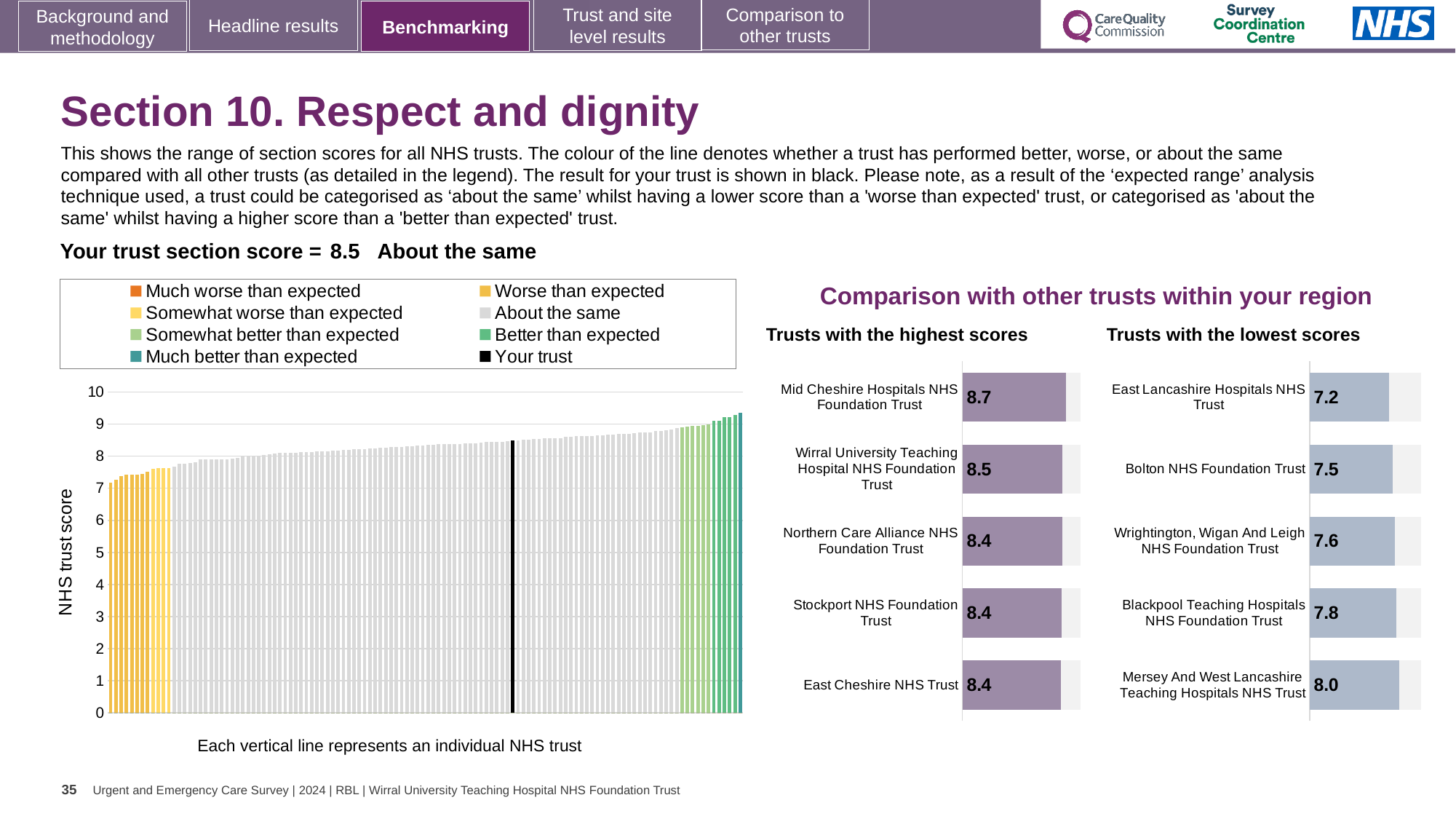
In the 'Trusts with the lowest scores' chart, which has the higher score: Bolton NHS Foundation Trust or Blackpool Teaching Hospitals NHS Foundation Trust? Blackpool Teaching Hospitals NHS Foundation Trust In the 'Trusts with the lowest scores' chart, which trust has the lowest score? East Lancashire Hospitals NHS Trust In the 'Trusts with the lowest scores' chart, what is the score for Bolton NHS Foundation Trust? 7.5 In the 'Trusts with the lowest scores' chart, what is the difference between the scores of Mersey And West Lancashire Teaching Hospitals NHS Trust and East Lancashire Hospitals NHS Trust? 0.8 What kind of chart is the large chart on the left showing NHS trust scores? Bar chart In the 'Trusts with the highest scores' chart, what is the difference between the scores of Mid Cheshire Hospitals NHS Foundation Trust and Wirral University Teaching Hospital NHS Foundation Trust? 0.2 In the large chart on the left, do the bar heights rise or fall from left to right? Rise How many entries does the legend above the large chart on the left list? 8 In the 'Trusts with the highest scores' chart, what is the score for Mid Cheshire Hospitals NHS Foundation Trust? 8.7 How many trusts are listed in the 'Trusts with the highest scores' chart? 5 In the large chart on the left, is the value of the tallest bar greater or less than 9? greater In the 'Trusts with the highest scores' chart, which trust has the highest score? Mid Cheshire Hospitals NHS Foundation Trust